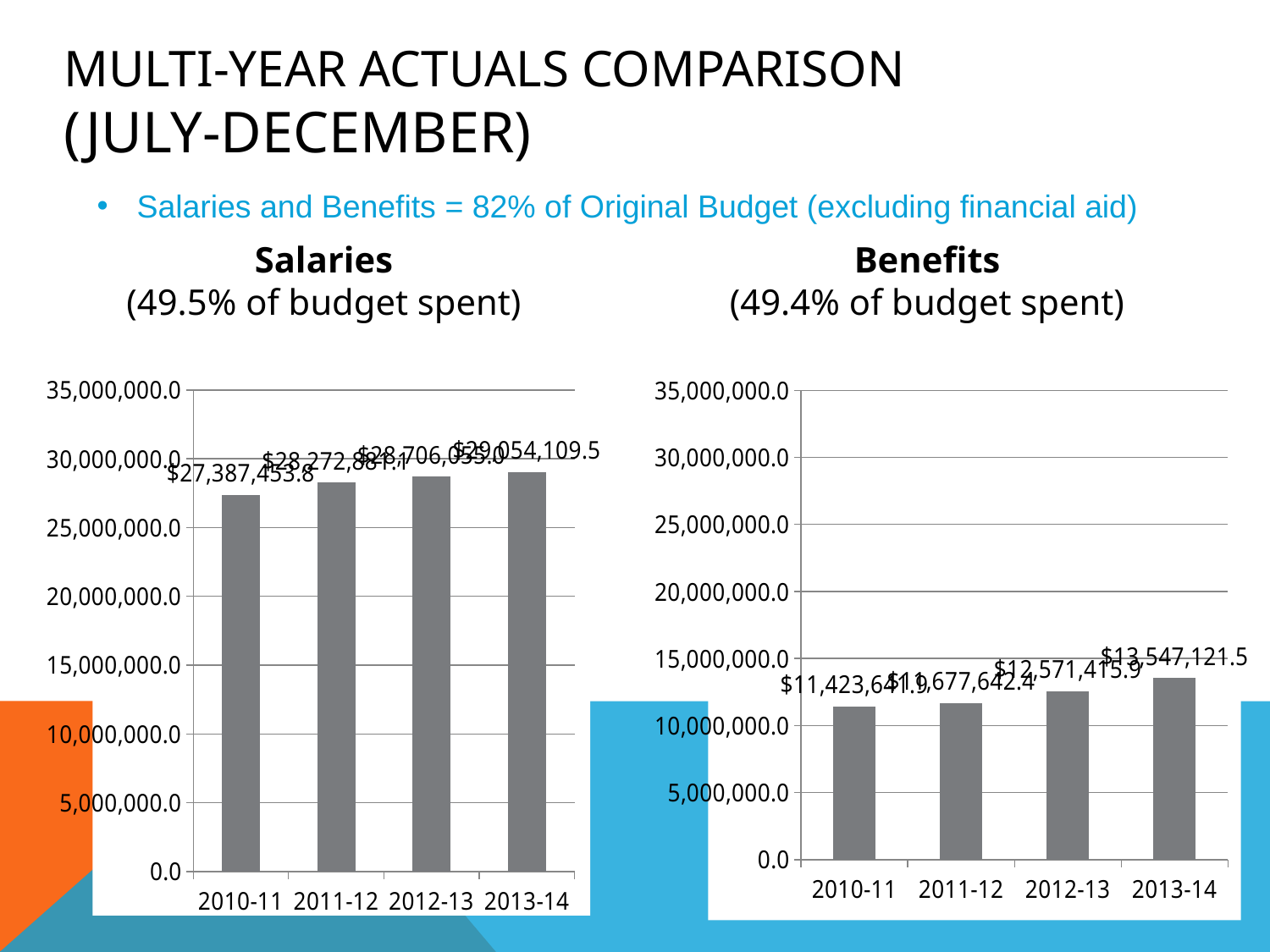
In the Salaries chart, what is the value for 2013-14? $29,054,109.5 In the Salaries chart, do the values rise or fall from 2010-11 to 2013-14? rise How many years are shown on the x axis of the Benefits chart? 4 In the Benefits chart, is the value for 2012-13 greater or less than 15,000,000? less In the Benefits chart, is the value for 2010-11 greater or less than 10,000,000? greater In the Benefits chart, what is the value for 2013-14? $13,547,121.5 In the Salaries chart, what is the value for 2010-11? $27,387,453.8 In the Salaries chart, which year has the highest value? 2013-14 In the Salaries chart, which year has the lowest value? 2010-11 In the Benefits chart, which year has the highest value? 2013-14 What kind of chart is the Salaries chart? bar chart In the Salaries chart, what is the difference between the 2013-14 value and the 2010-11 value? $1,666,655.7